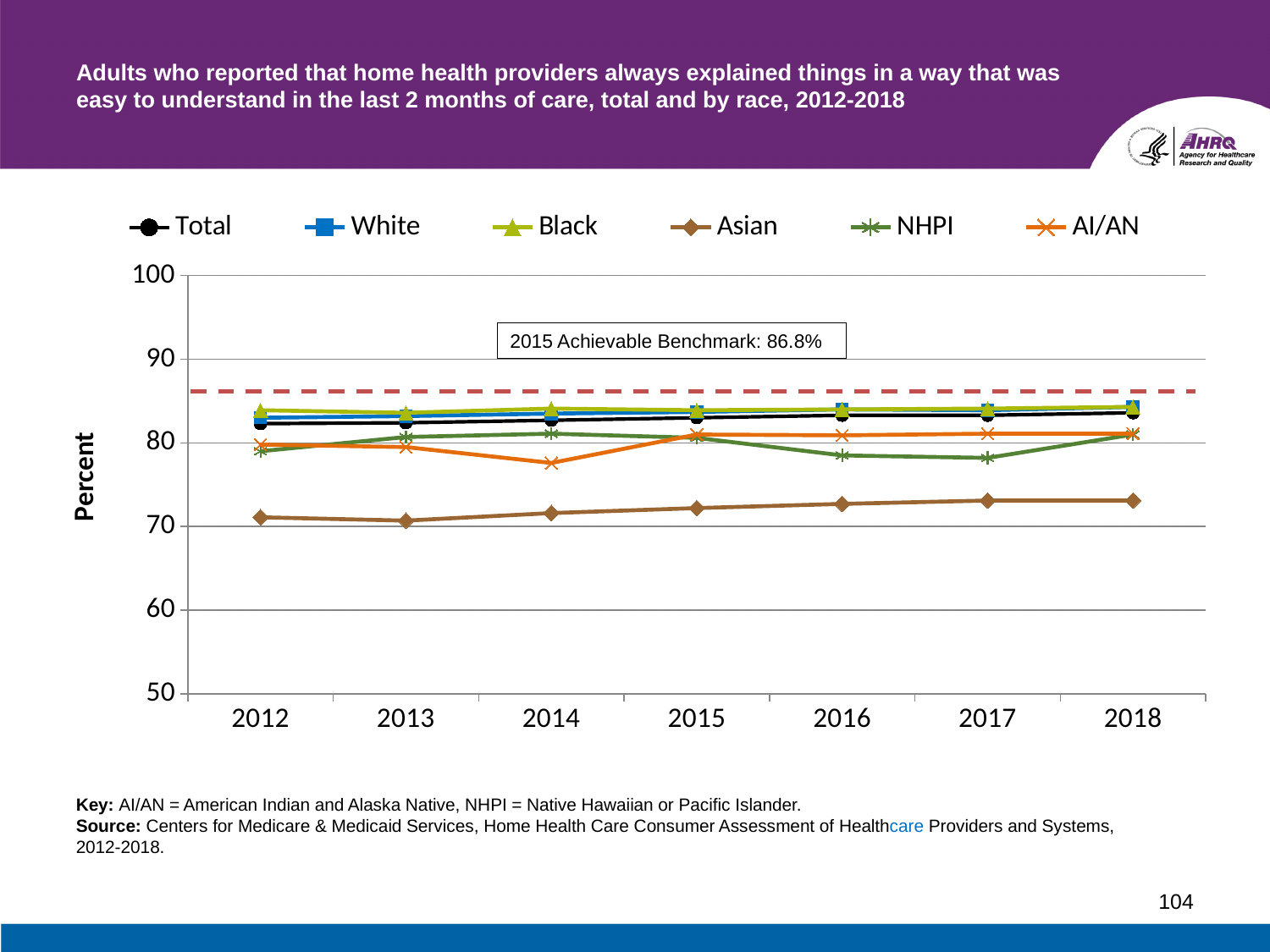
Is the value for AI/AN in 2014 greater or less than 80? less What kind of chart is shown on the slide? Line chart Does the Asian series rise or fall from 2012 to 2018? Rises In 2016, which is larger, the value for NHPI or the value for Asian? NHPI How many series does the legend list? 6 How many years are shown along the x axis? 7 Is the value for NHPI in 2017 greater or less than 80? less Which series has the lowest values across all years? Asian What is the label on the y axis? Percent Is the value for Total in 2018 greater or less than 80? greater What is the 2015 Achievable Benchmark value shown on the chart? 86.8%